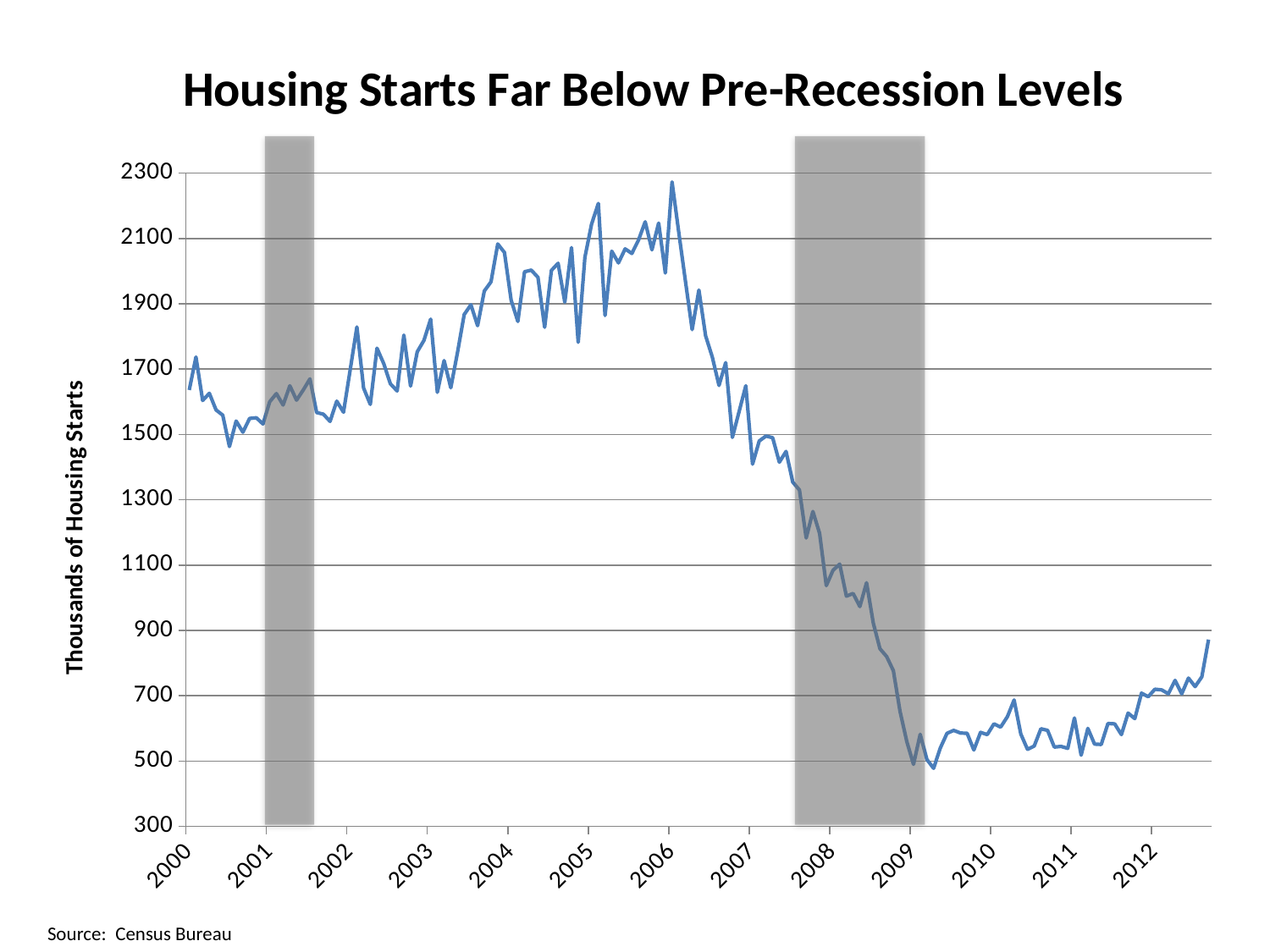
What is the label on the vertical axis of the chart? Thousands of Housing Starts Does the line rise or fall between the 2009 tick and the end of the series in 2012? rise Is the value of housing starts at the 2010 tick greater or less than 500? greater Is the value of housing starts at the 2011 tick greater or less than 700? less Is the value of housing starts at the 2008 tick greater or less than 900? greater What is the title of the chart? Housing Starts Far Below Pre-Recession Levels What kind of chart is shown on the slide? line chart Does the line rise or fall between the 2006 tick and the 2009 tick? fall Which is larger, the value of housing starts at the 2006 tick or at the 2010 tick? 2006 Around which year on the x axis does the line reach its highest point? 2006